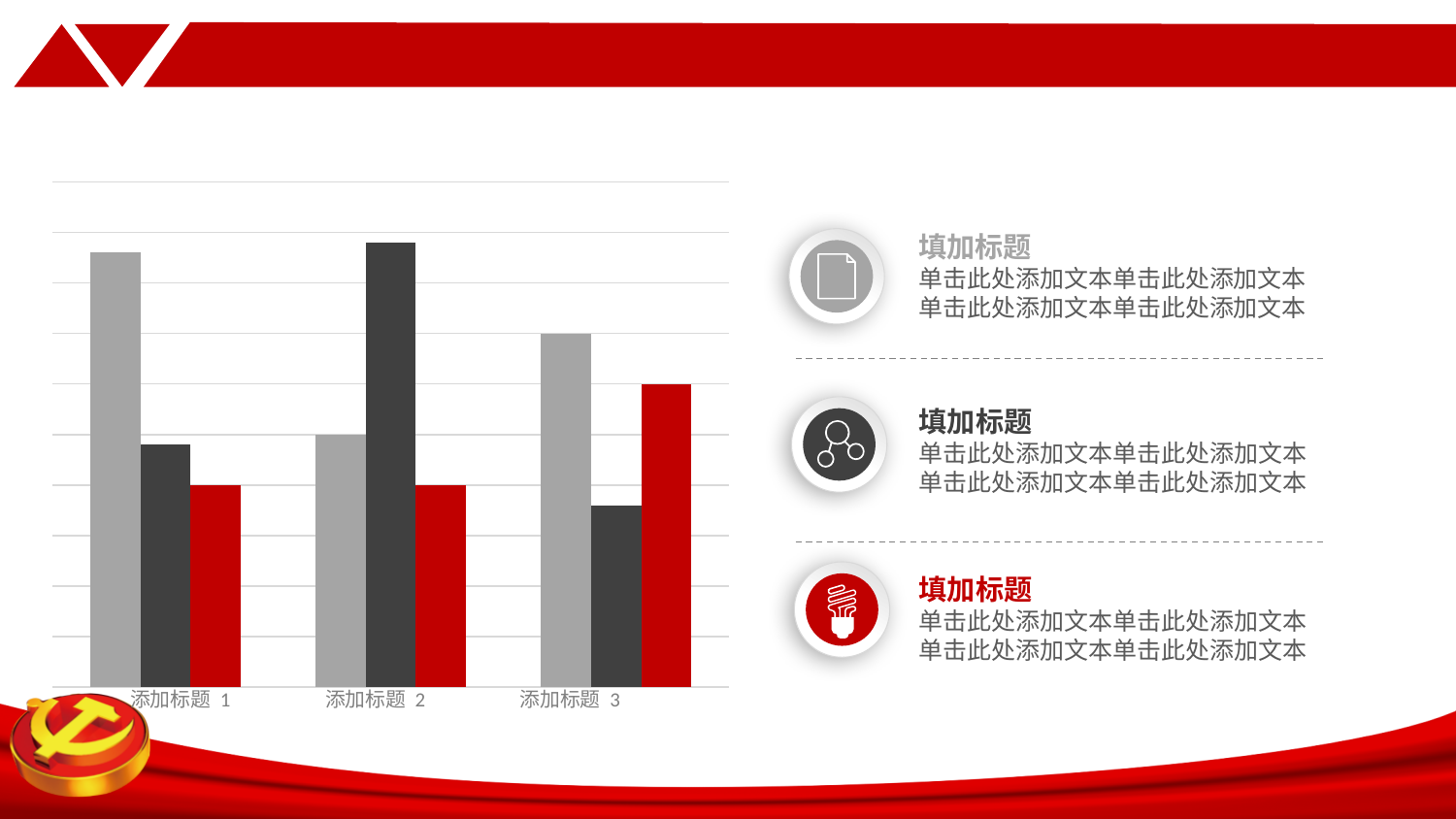
Does the dark gray bar rise or fall from 添加标题 2 to 添加标题 3? Fall Which category has the tallest light gray bar? 添加标题 1 What kind of chart is shown on the left of the slide? Bar chart Which category has the tallest red bar? 添加标题 3 How many categories are shown on the x axis of the bar chart? 3 What three colours are used for the bars in the chart? Light gray, dark gray and red Which category has the shortest dark gray bar? 添加标题 3 In category 添加标题 2, which bar is the tallest? The dark gray bar Which category has the tallest dark gray bar? 添加标题 2 In category 添加标题 1, which bar is the tallest? The light gray bar How many data series (bars per category) are plotted in the bar chart? 3 In category 添加标题 3, is the red bar taller or shorter than the light gray bar? Shorter